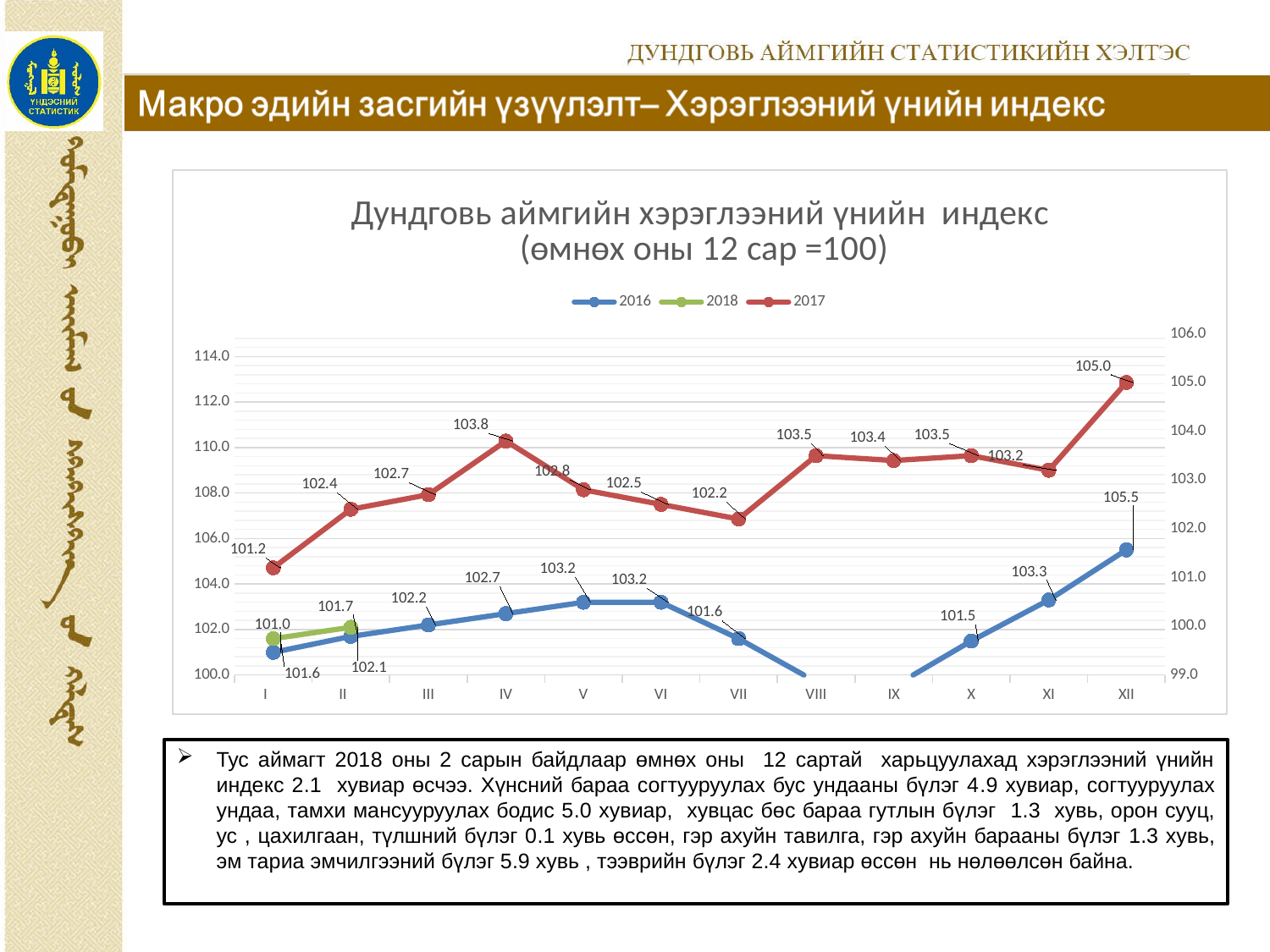
What is the value of the 2017 series at month XII? 105.0 For the 2016 series, which is larger: the value at month XI or at month X? XI In which month does the 2017 series have its lowest value? I What is the value of the 2016 series at month X? 101.5 How many series does the chart legend list? 3 What is the value of the 2017 series at month IV? 103.8 In which month does the 2017 series reach its highest value? XII Which series are listed in the chart legend? 2016, 2018, 2017 What kind of chart is shown on the slide? line chart What is the difference between the 2017 series values at month XII and month I? 3.8 How many months are shown on the x axis? 12 What is the value of the 2016 series at month XII? 105.5